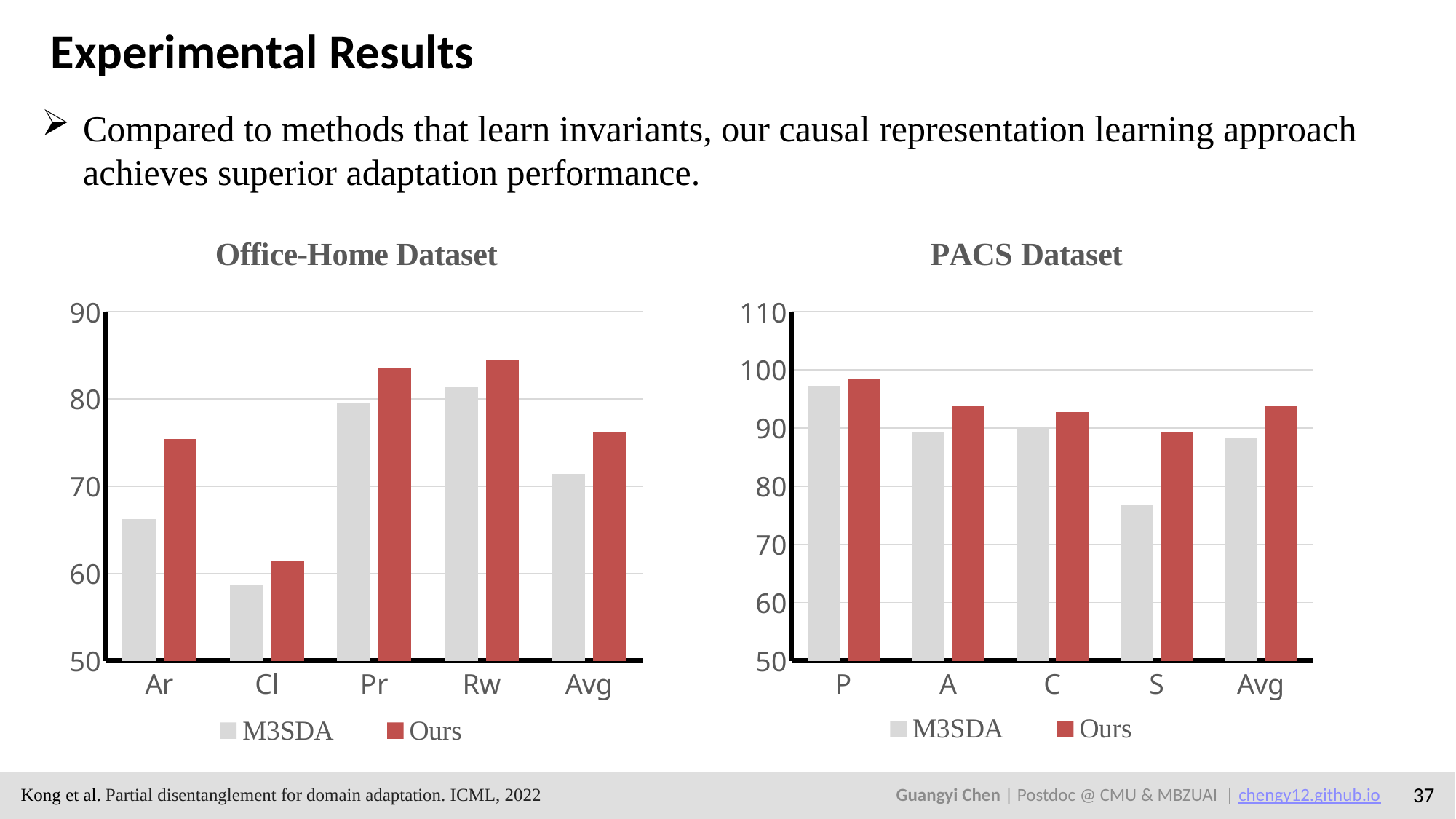
In the Office-Home Dataset chart, which category has the highest value for Ours? Rw In the PACS Dataset chart, which category has the highest value for Ours? P What are the two legend entries in the PACS Dataset chart? M3SDA and Ours In the PACS Dataset chart, is the M3SDA value for S greater or less than 80? less In the Office-Home Dataset chart, is the M3SDA value for Ar greater or less than 70? less How many series does the legend of the Office-Home Dataset chart list? 2 How many categories are shown on the x axis of the Office-Home Dataset chart? 5 In the Office-Home Dataset chart, which category has the lowest value for M3SDA? Cl In the Office-Home Dataset chart, is the Ours value for Pr greater or less than 80? greater In the PACS Dataset chart, which series has the larger value for S, M3SDA or Ours? Ours What kind of chart is the Office-Home Dataset chart? bar chart In the PACS Dataset chart, which category has the lowest value for M3SDA? S